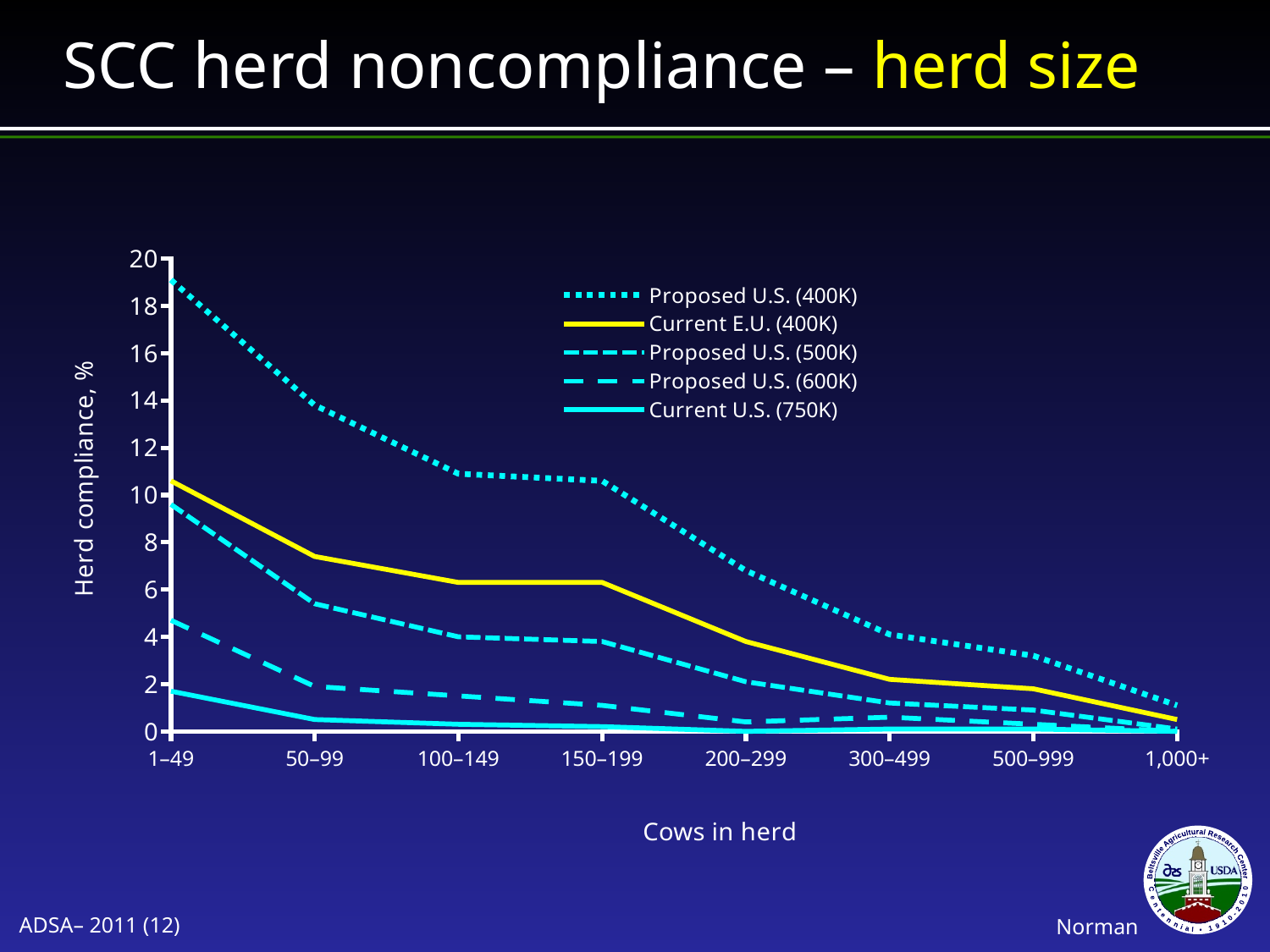
Do the values for Proposed U.S. (400K) rise or fall as herd size increases along the x axis? fall For which herd size is the Current E.U. (400K) value highest? 1–49 At the 150–199 herd size, which is larger: Current E.U. (400K) or Proposed U.S. (500K)? Current E.U. (400K) What kind of chart is shown on the slide? line chart Is the value for Proposed U.S. (400K) at 1–49 greater or less than 18? greater Is the value for Proposed U.S. (500K) at 50–99 greater or less than 8? less Which series has the lowest value at the 1–49 herd size? Current U.S. (750K) What is the label of the y axis? Herd compliance, % Which series has the highest value at the 1–49 herd size? Proposed U.S. (400K) How many series does the legend list? 5 For which herd size is the Proposed U.S. (400K) value lowest? 1,000+ How many herd-size categories are shown on the x axis? 8